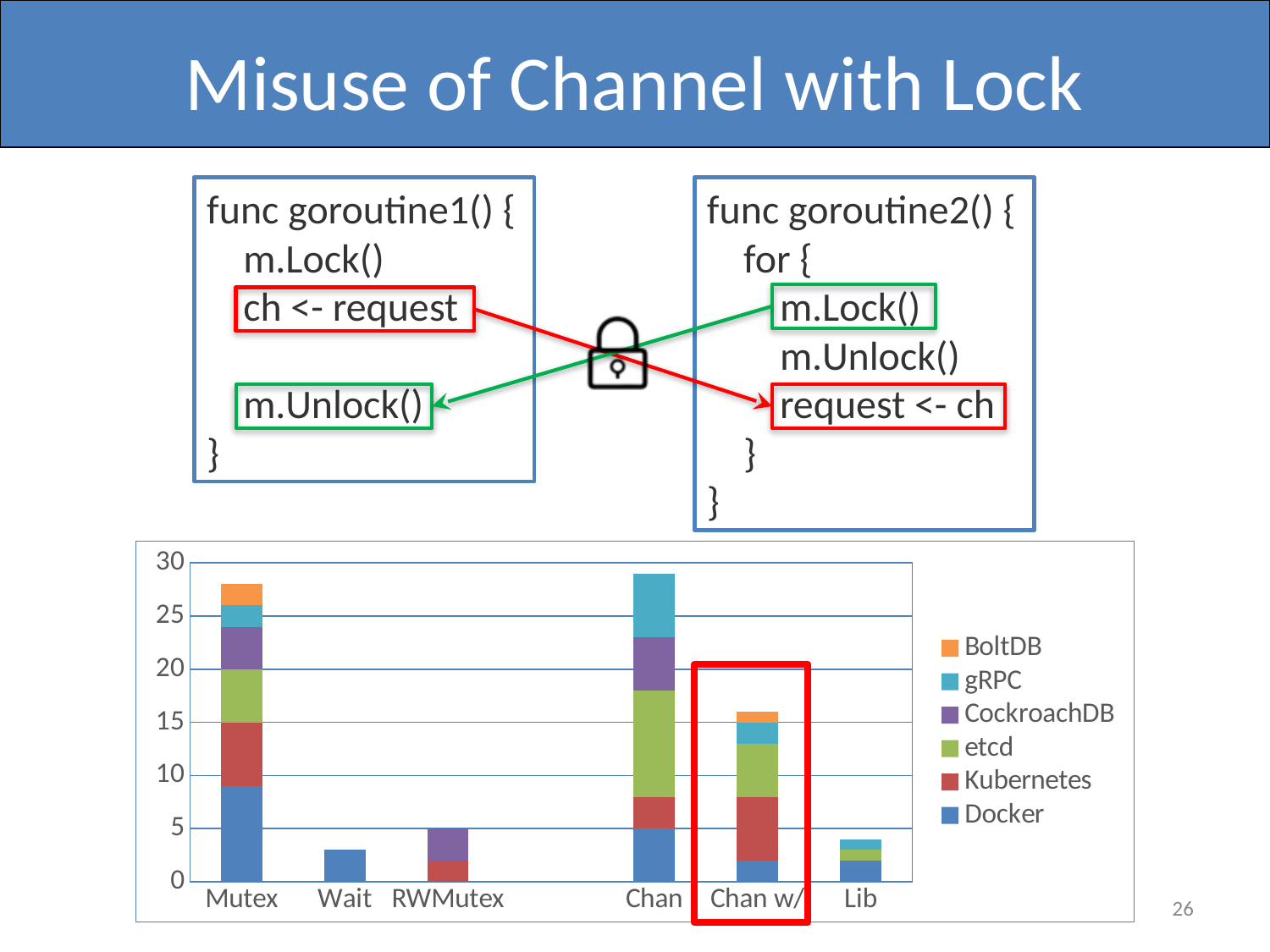
How many series does the legend list? 6 What kind of chart is shown on the slide? stacked bar chart Which category's bar is highlighted with a red box? Chan w/ Is the total value for Chan greater or less than 25? greater Which series is listed last (at the bottom) in the legend? Docker Which has the larger total, Chan or Lib? Chan How many labelled categories are on the x axis? 6 Which has the larger total, Mutex or Chan w/? Mutex Is the total value for Lib greater or less than 5? less Is the total value for Chan w/ greater or less than 10? greater